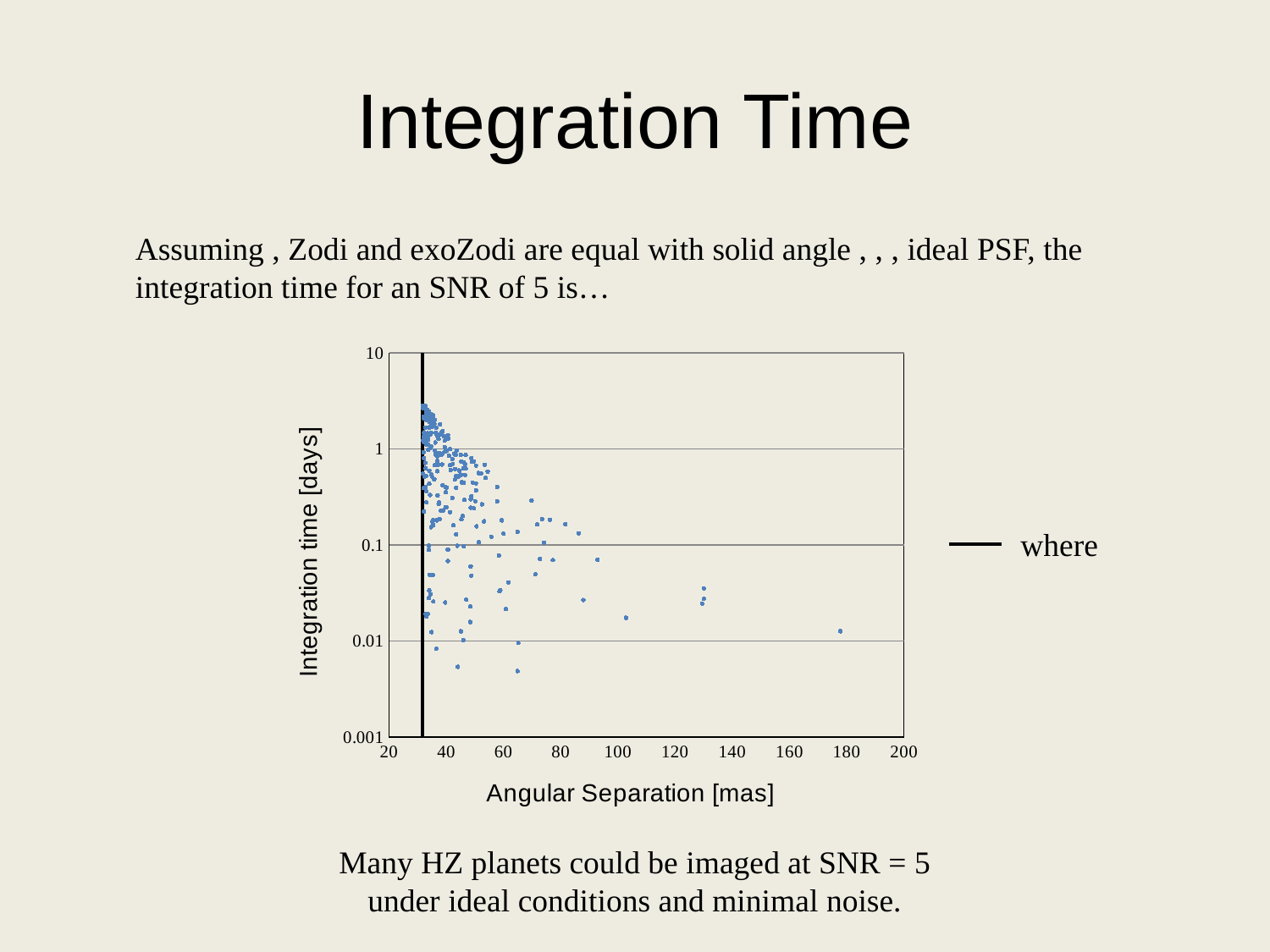
What is the lowest value shown on the y axis of the chart? 0.001 Do the integration times generally rise or fall as angular separation increases along the x axis? fall Is the integration time of the highest point in the cluster near 30 mas greater or less than 1 day? greater Are there any points plotted at angular separations greater than 180 mas? no What is the label of the y axis of the chart? Integration time [days] What is the highest value shown on the y axis of the chart? 10 What kind of chart is shown on the slide? scatter plot What is the lowest value shown on the x axis of the chart? 20 Is the integration time of the rightmost point (near 180 mas) greater or less than 0.1 days? less What is the highest value shown on the x axis of the chart? 200 Is the vertical black line on the chart located at an angular separation greater or less than 40 mas? less What is the label of the x axis of the chart? Angular Separation [mas]